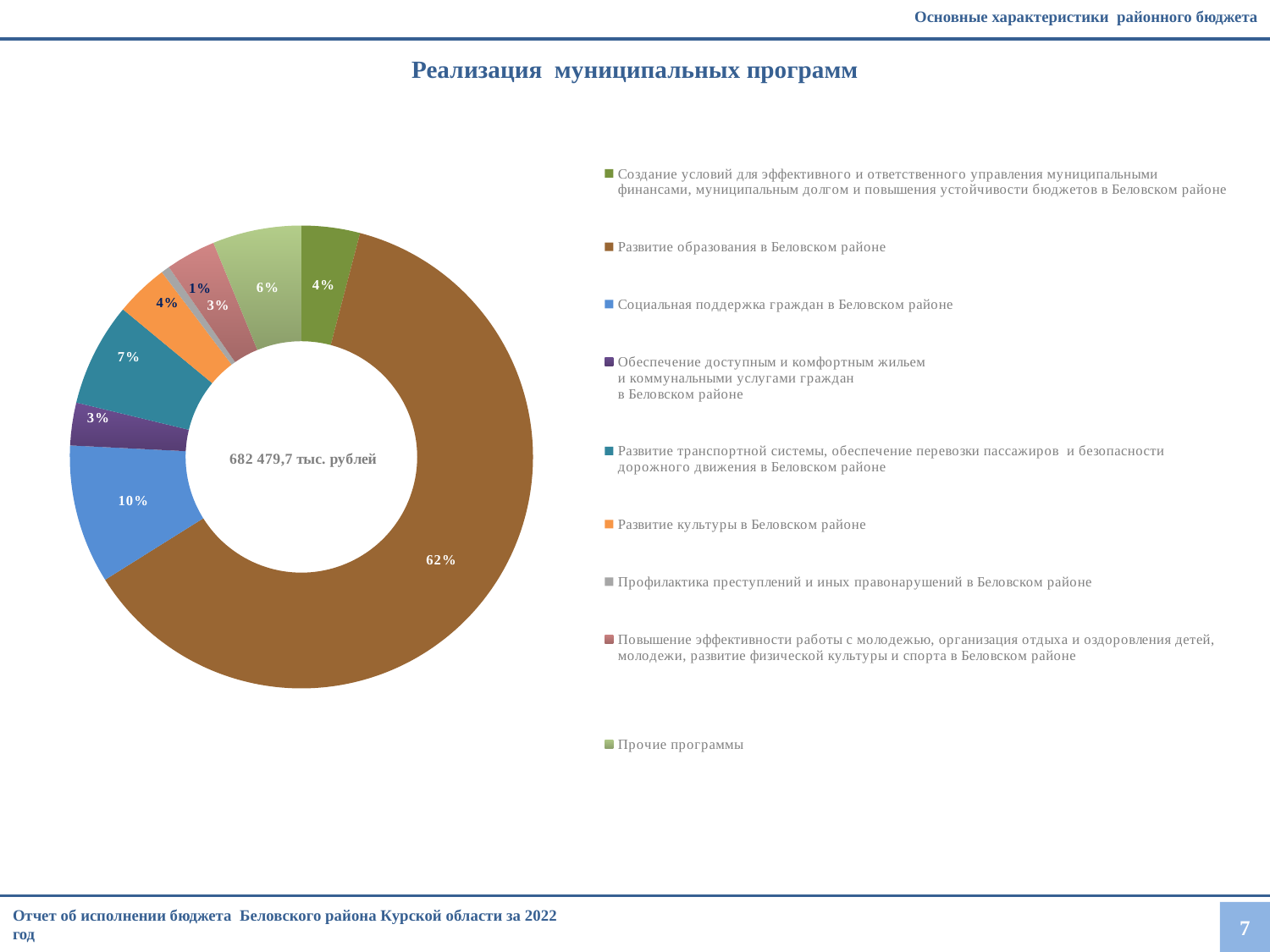
Какая программа занимает наименьшую долю на диаграмме? Профилактика преступлений и иных правонарушений в Беловском районе Какой тип диаграммы показан на слайде? кольцевая (круговая) диаграмма На сколько процентных пунктов доля программы «Развитие образования в Беловском районе» больше доли программы «Социальная поддержка граждан в Беловском районе»? 52 Сколько программ (категорий) перечислено в легенде диаграммы? 9 Что больше: доля программы «Развитие транспортной системы…» или доля программы «Развитие культуры в Беловском районе»? Развитие транспортной системы Какая доля приходится на «Прочие программы»? 6% Какая доля приходится на программу «Профилактика преступлений и иных правонарушений в Беловском районе»? 1% Какая доля приходится на программу «Социальная поддержка граждан в Беловском районе»? 10% Какая доля приходится на программу «Развитие образования в Беловском районе»? 62% Какая общая сумма указана в центре диаграммы? 682 479,7 тыс. рублей Какая доля приходится на программу «Развитие транспортной системы, обеспечение перевозки пассажиров и безопасности дорожного движения в Беловском районе»? 7% Какая программа занимает наибольшую долю на диаграмме? Развитие образования в Беловском районе